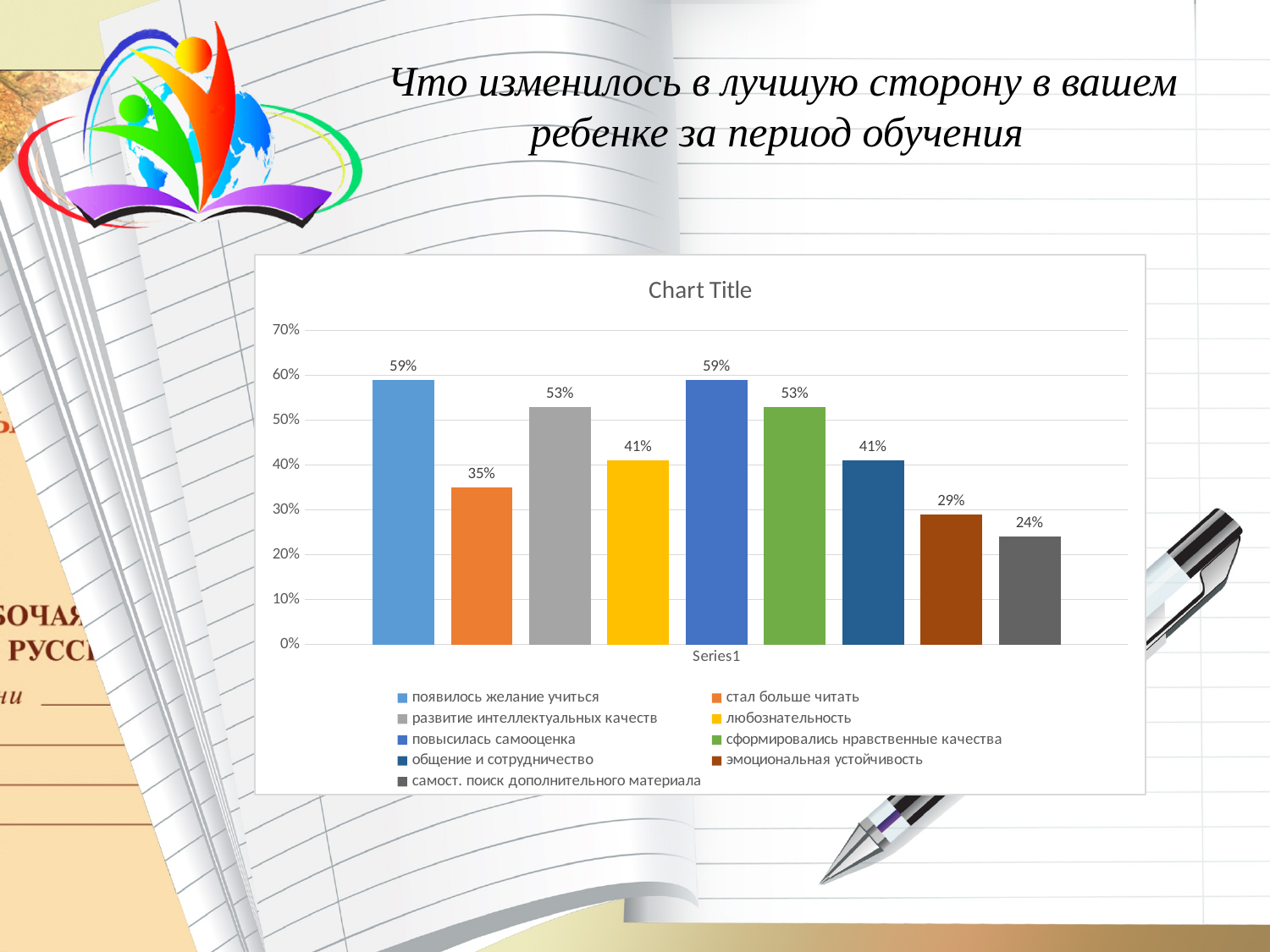
What value is shown for "повысилась самооценка"? 59% What is the difference between the values for "развитие интеллектуальных качеств" and "самост. поиск дополнительного материала"? 29% Which is larger: the value for "сформировались нравственные качества" or the value for "общение и сотрудничество"? сформировались нравственные качества What value is shown for "эмоциональная устойчивость"? 29% Which legend entry has the lowest value? самост. поиск дополнительного материала What kind of chart is shown on the slide? bar chart Is the value for "эмоциональная устойчивость" greater or less than 30%? less What value is shown for "стал больше читать"? 35% What value is shown for "любознательность"? 41% How many bars are plotted in the chart? 9 What is the difference between the values for "появилось желание учиться" and "стал больше читать"? 24% How many entries does the legend list? 9